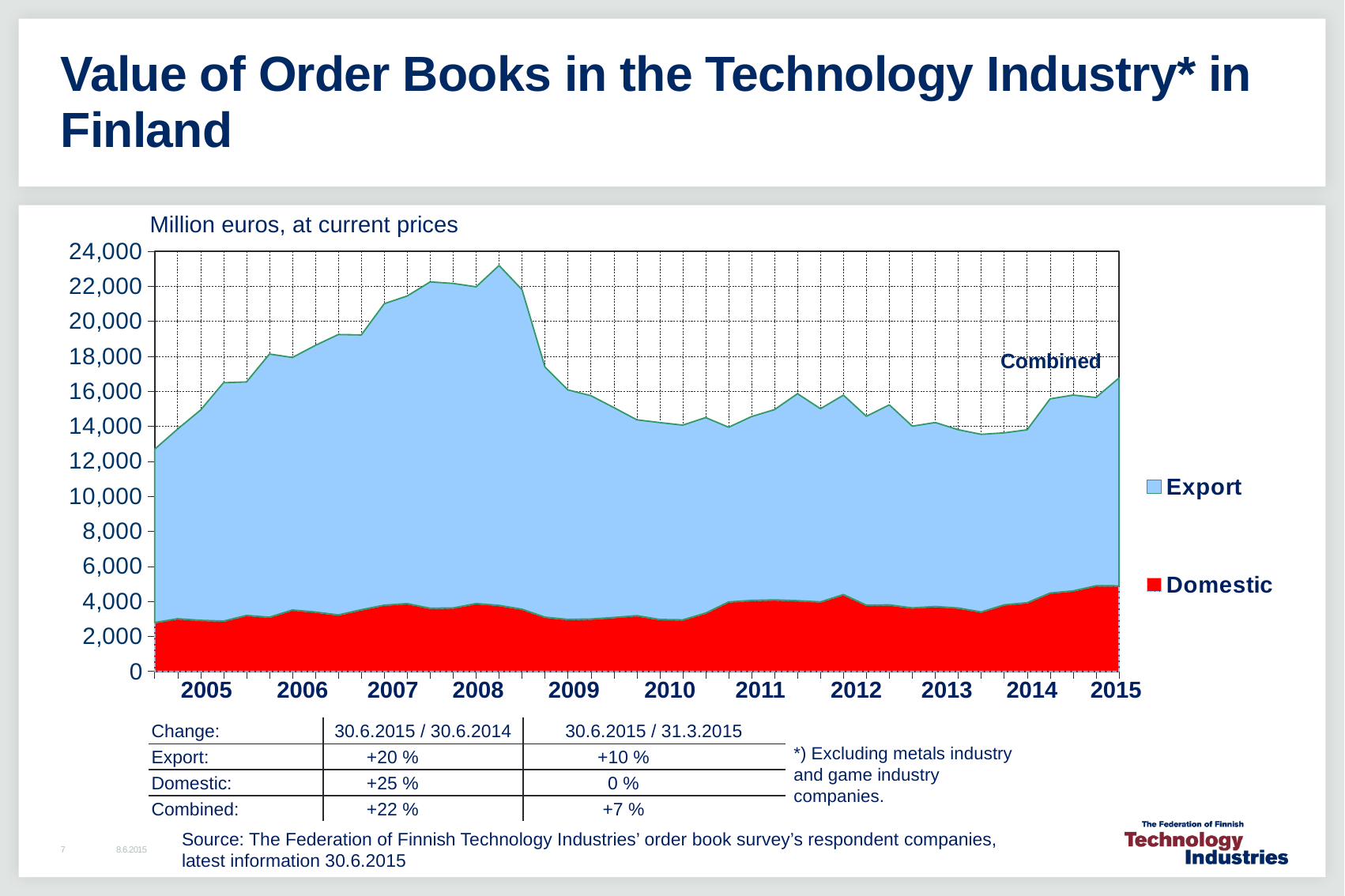
According to the change table below the chart, what is the Export change for 30.6.2015 / 30.6.2014? +20 % Does the combined value rise or fall between its 2008 peak and 2009? Fall Is the Domestic value at any point greater or less than 6,000? less How many year labels are shown on the x axis? 11 Which series is larger throughout the period, Export or Domestic? Export Which two series are listed in the chart legend? Export and Domestic What unit is stated above the chart for the values? Million euros, at current prices In which year does the combined value of order books reach its highest peak? 2008 Is the combined value at its 2008 peak greater or less than 22,000? greater What kind of chart is shown on the slide? Stacked area chart How many series does the chart legend list? 2